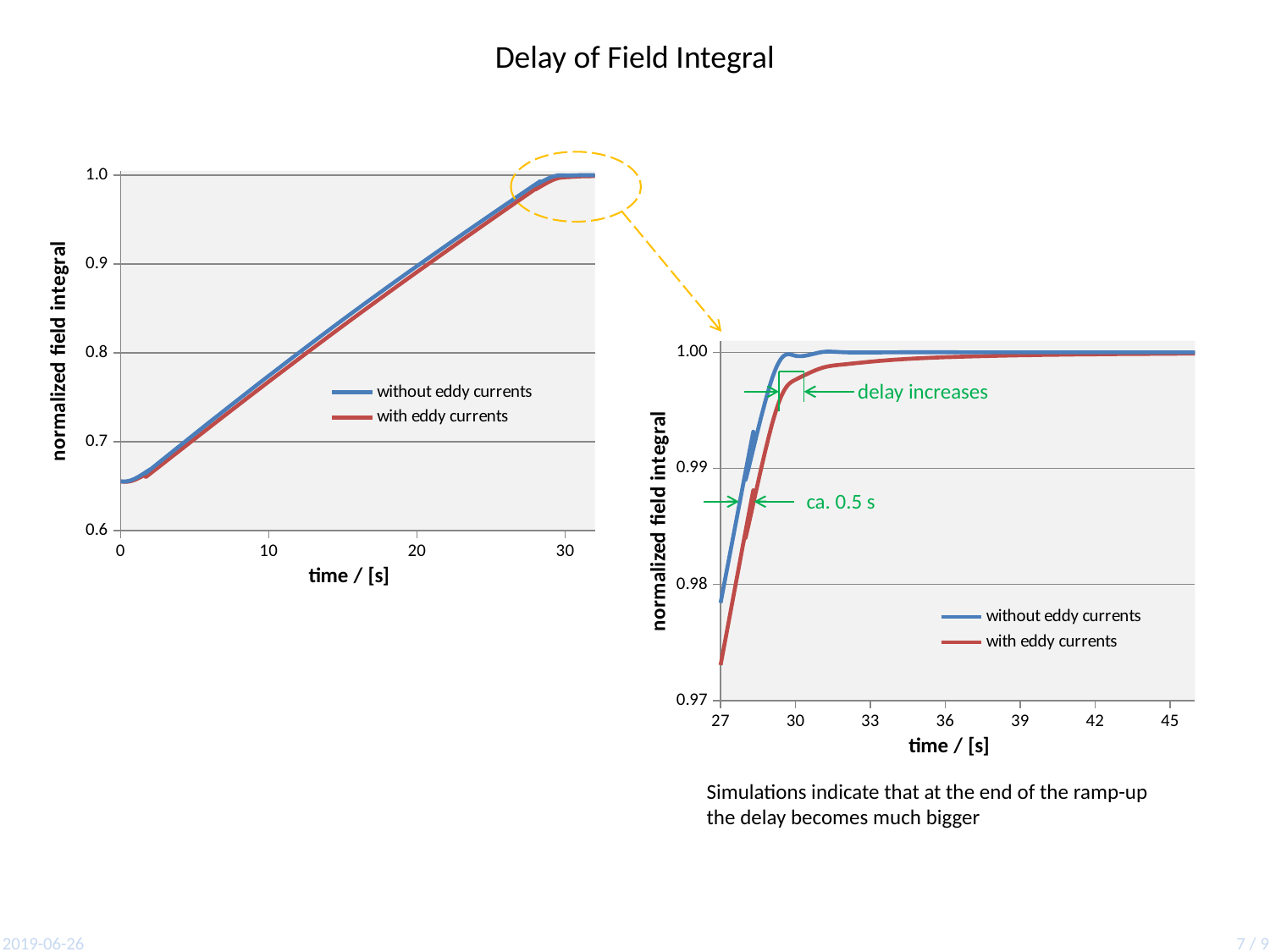
What delay value is annotated in green on the right (zoomed) chart? ca. 0.5 s In the right (zoomed) chart, is the value of 'without eddy currents' at time 27 greater or less than 0.99? less What kind of chart is the left chart titled with the y axis 'normalized field integral' and x axis from 0 to 30? line chart In the left chart, do the values of 'without eddy currents' rise or fall as time increases from 0 to 30 s? rise In the left chart, is the value of 'with eddy currents' at time 25 greater or less than 0.9? greater In the left chart, is the value of 'without eddy currents' at time 0 greater or less than 0.7? less How many series does the legend of the left chart list? 2 In the right (zoomed) chart, which series has the higher value at time 30? without eddy currents What are the two legend entries of the right (zoomed) chart? without eddy currents; with eddy currents